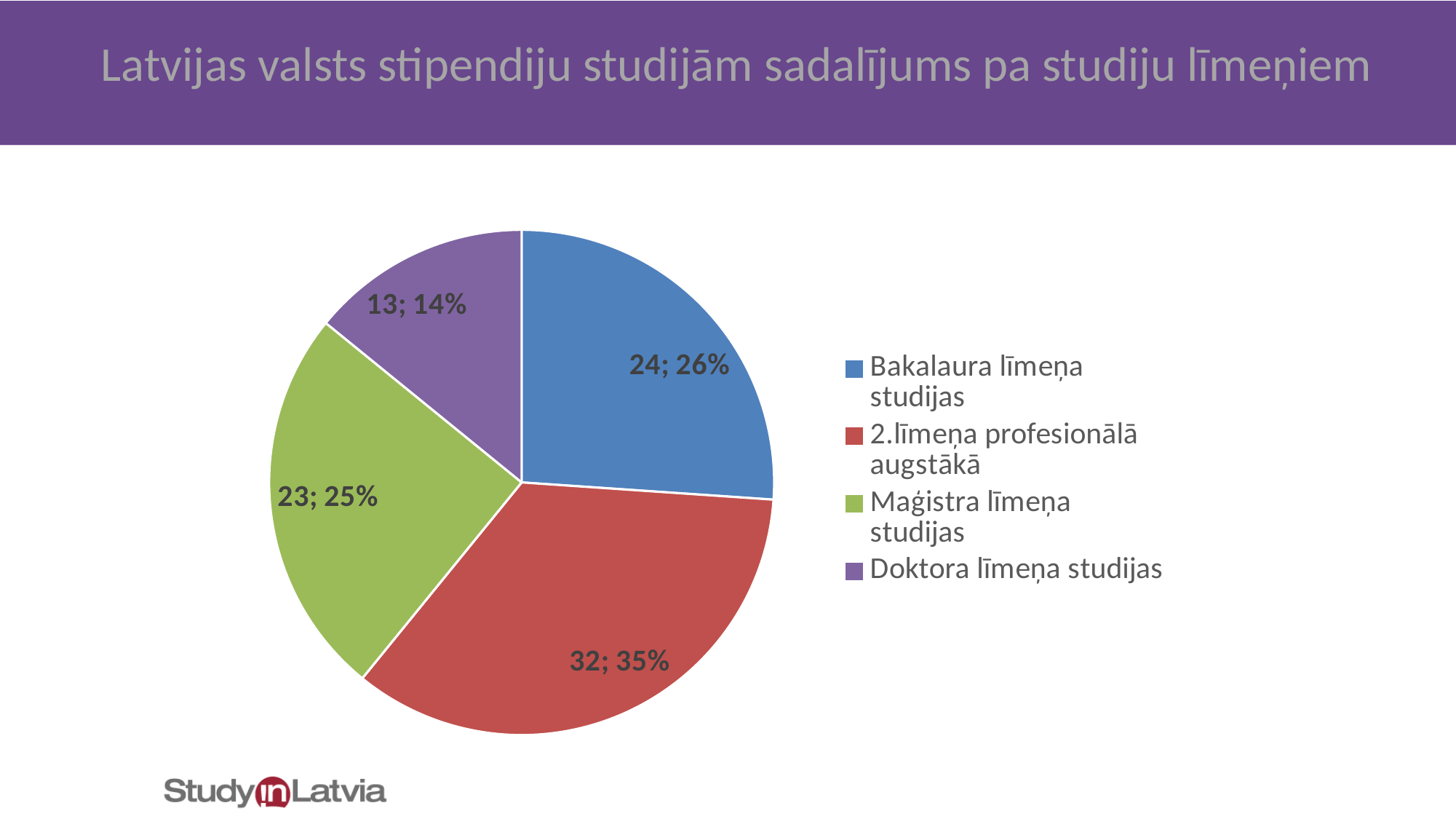
What is the value for 2.līmeņa profesionālā augstākā? 32 What is the difference between the values for 2.līmeņa profesionālā augstākā and Doktora līmeņa studijas? 19 Which category has the smallest slice? Doktora līmeņa studijas What share of the pie does Doktora līmeņa studijas represent? 14% What is the value for Doktora līmeņa studijas? 13 What kind of chart is shown on the slide? pie chart What is the title of the chart on the slide? Latvijas valsts stipendiju studijām sadalījums pa studiju līmeņiem Which category has the largest slice? 2.līmeņa profesionālā augstākā What is the value for Maģistra līmeņa studijas? 23 What is the value for Bakalaura līmeņa studijas? 24 How many slices does the pie chart have? 4 What share of the pie does 2.līmeņa profesionālā augstākā represent? 35%